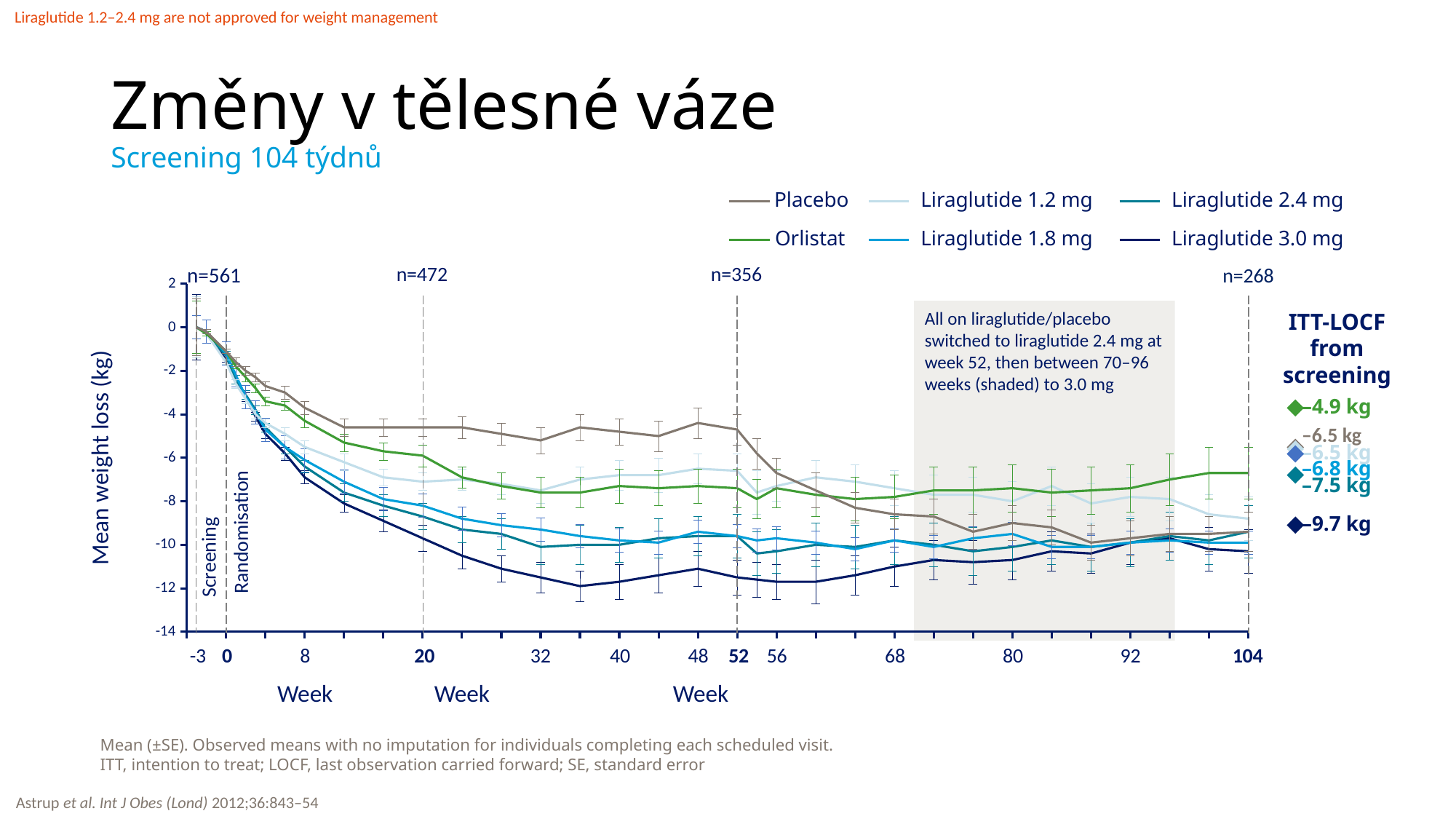
Which treatment shows the smallest ITT-LOCF weight loss from screening? Orlistat How many series does the legend list? 6 Do the mean weight loss values for Liraglutide 3.0 mg rise or fall between week 0 and week 20? fall What is the ITT-LOCF weight change from screening for Liraglutide 2.4 mg? −7.5 kg How many participants (n) are shown at week 52? n=356 What is the ITT-LOCF weight change from screening for Liraglutide 1.8 mg? −6.8 kg What is the difference between the ITT-LOCF weight loss for Liraglutide 3.0 mg and Orlistat? 4.8 kg Is the mean weight loss for Liraglutide 3.0 mg at week 36 greater or less than −10 kg? less What is the ITT-LOCF weight change from screening for Orlistat? −4.9 kg Which treatment shows the greatest ITT-LOCF weight loss from screening? Liraglutide 3.0 mg What is the ITT-LOCF weight change from screening for Liraglutide 3.0 mg? −9.7 kg What kind of chart is shown on the slide? line chart